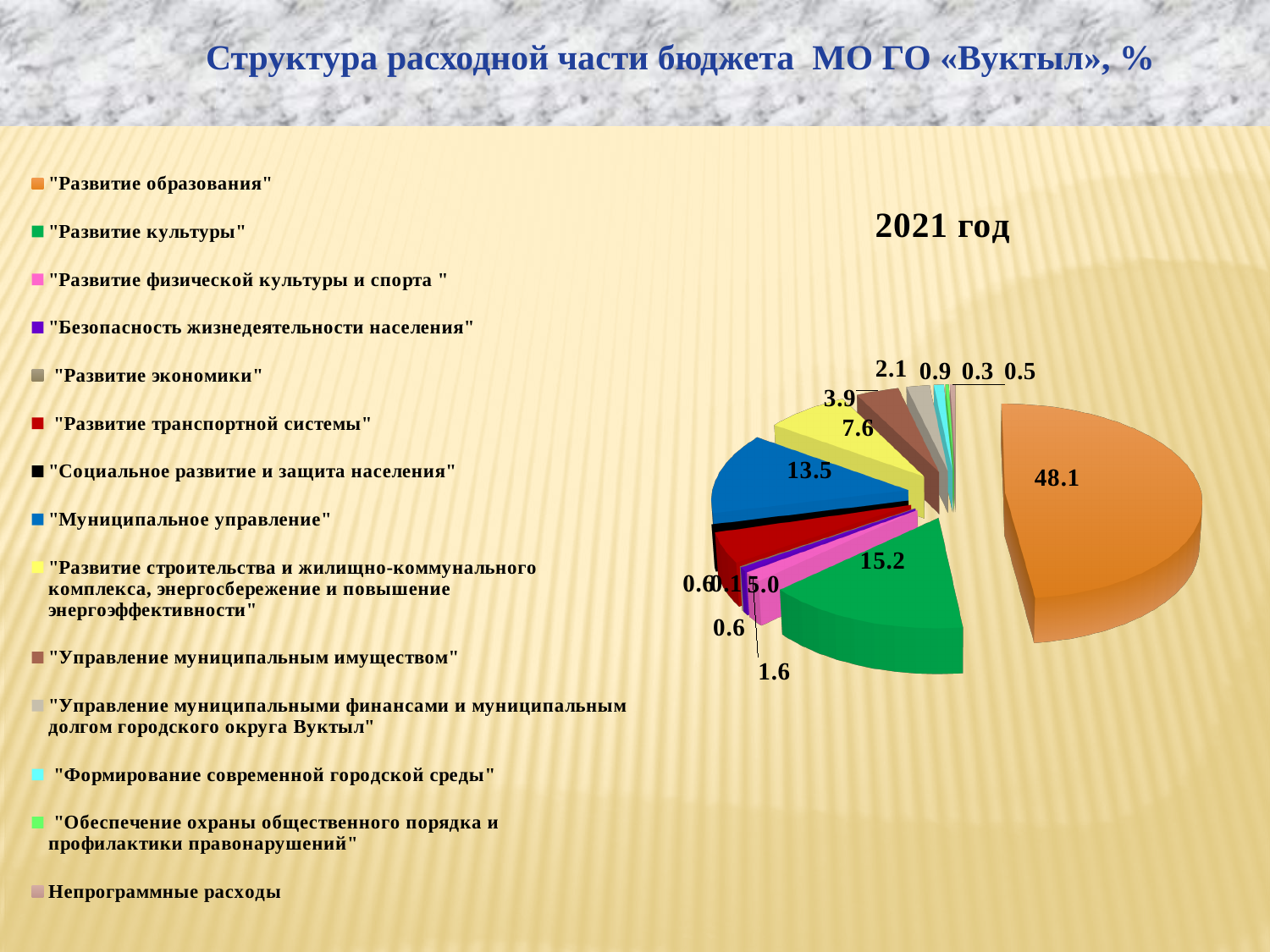
What kind of chart is shown on the slide? pie chart What is the smallest value labeled on the pie chart? 0.1 What value is shown for "Развитие образования"? 48.1 What is the difference between the values for "Развитие образования" and "Развитие культуры"? 32.9 Which is larger, the value for "Развитие культуры" or the value for "Муниципальное управление"? "Развитие культуры" What value is shown for "Муниципальное управление"? 13.5 What value is shown for "Развитие культуры"? 15.2 What is the title shown above the pie chart? 2021 год Which category has the largest slice of the pie? "Развитие образования" What share of the pie does the "Развитие образования" slice represent? 48.1% How many categories does the legend of the pie chart list? 14 What value is shown for "Развитие строительства и жилищно-коммунального комплекса, энергосбережение и повышение энергоэффективности"? 7.6